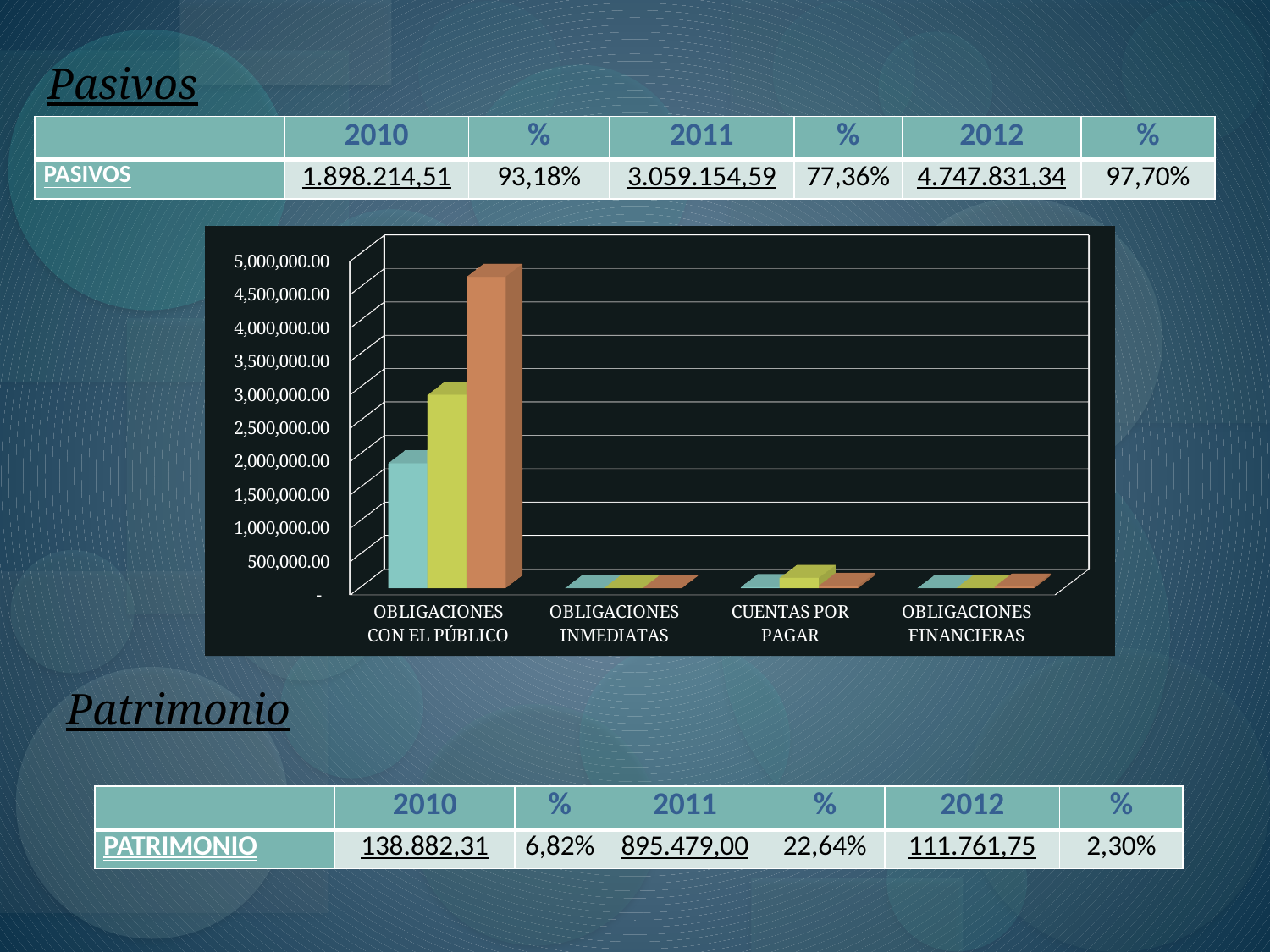
Which category has the tallest bars in the chart? OBLIGACIONES CON EL PÚBLICO Which category has a taller middle (green) bar, CUENTAS POR PAGAR or OBLIGACIONES INMEDIATAS? CUENTAS POR PAGAR How many categories are shown on the x axis of the chart? 4 What colour is the tallest bar in the chart? orange Is the tallest bar for OBLIGACIONES CON EL PÚBLICO greater or less than 4,000,000.00? greater What is the highest value labelled on the vertical axis of the chart? 5,000,000.00 What kind of chart is shown on the slide? bar chart How many bars are plotted for each category in the chart? 3 Is the shortest (teal) bar for OBLIGACIONES CON EL PÚBLICO greater or less than 2,500,000.00? less Is the tallest bar for OBLIGACIONES CON EL PÚBLICO greater or less than 4,500,000.00? greater Which category has larger bars, OBLIGACIONES CON EL PÚBLICO or CUENTAS POR PAGAR? OBLIGACIONES CON EL PÚBLICO